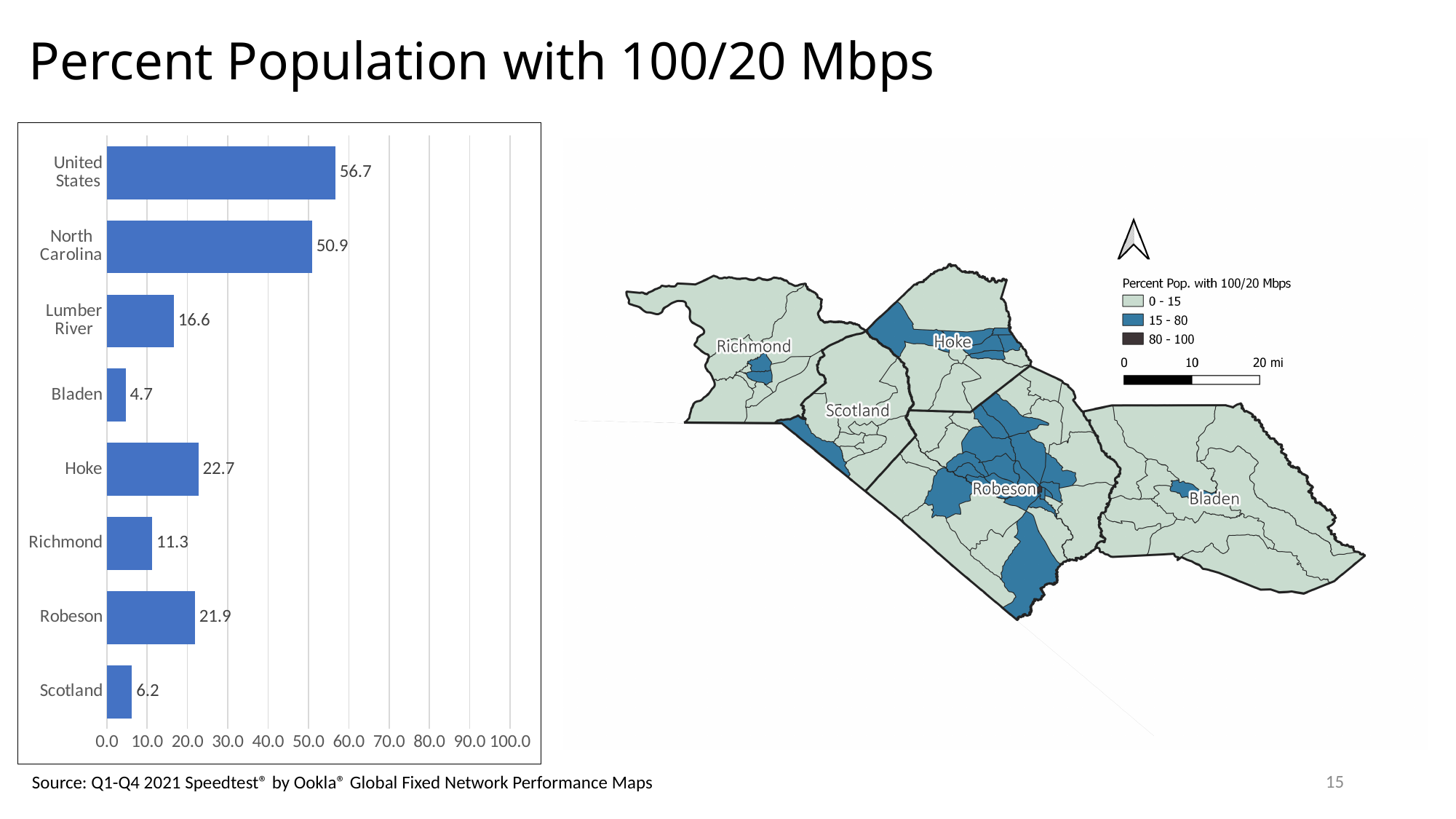
What is the value for North Carolina in the bar chart? 50.9 What is the value for Hoke in the bar chart? 22.7 What is the difference between the values for United States and North Carolina in the bar chart? 5.8 Is the value for Robeson in the bar chart greater or less than 20.0? greater Which category has the lowest value in the bar chart? Bladen What is the value for Scotland in the bar chart? 6.2 What is the difference between the values for Hoke and Robeson in the bar chart? 0.8 What kind of chart is shown on the left of the slide? bar chart Which category has the highest value in the bar chart? United States Which has a larger value in the bar chart, Lumber River or Richmond? Lumber River How many categories are shown in the bar chart? 8 What is the title of the slide? Percent Population with 100/20 Mbps